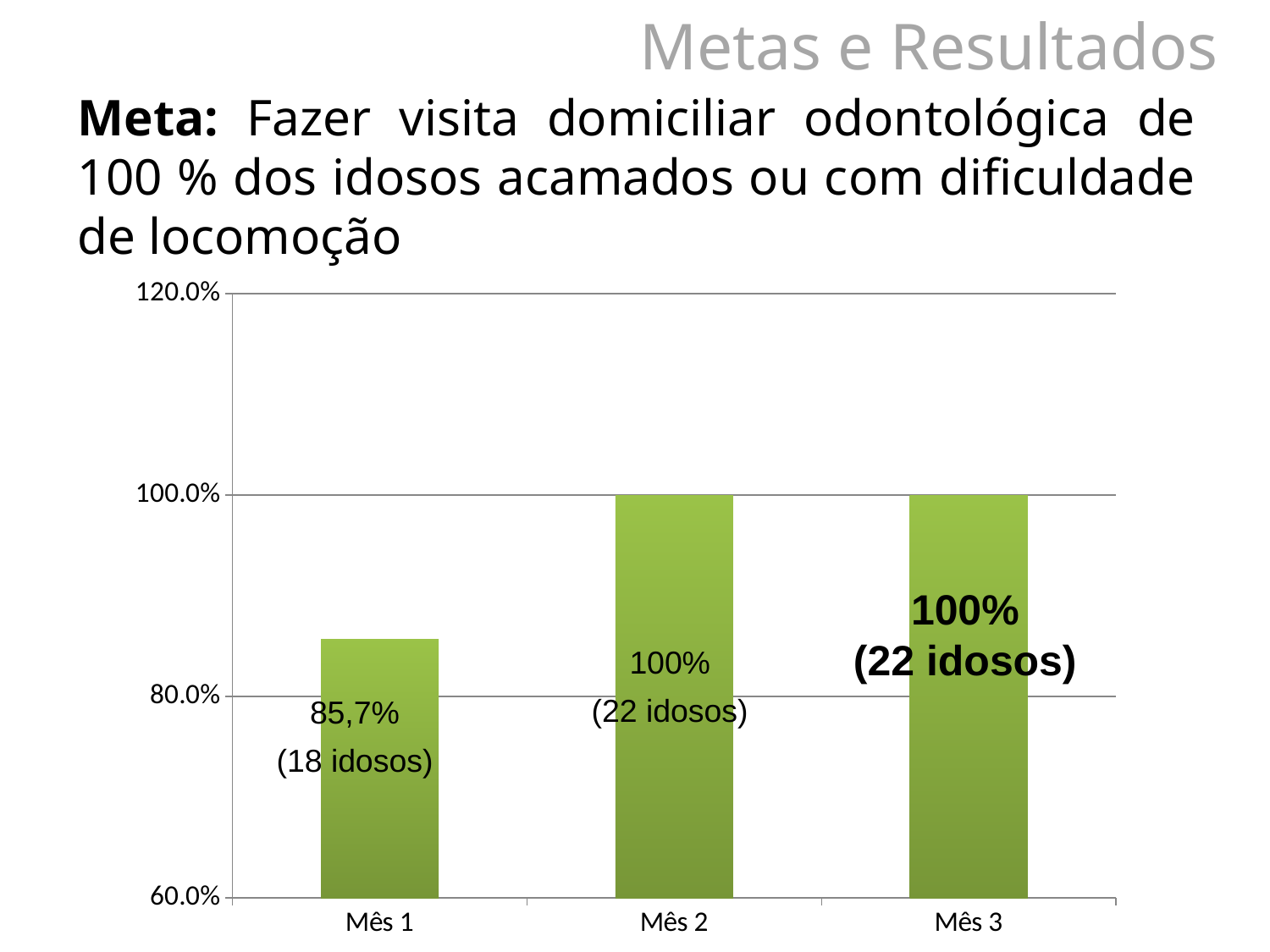
Is the value for Mês 1 greater or less than 80.0%? greater Which is larger, the value for Mês 1 or the value for Mês 3? Mês 3 Which month has the lowest value? Mês 1 What is the highest value shown on the y axis? 120.0% What is the value shown for Mês 1? 85,7% What kind of chart is shown on the slide? bar chart What is the difference between the value for Mês 2 and the value for Mês 1? 14,3% What is the value shown for Mês 2? 100% How many idosos does the label for Mês 1 indicate? 18 idosos How many months are shown on the x axis? 3 Do the values rise or fall from Mês 1 to Mês 2? rise How many idosos does the label for Mês 3 indicate? 22 idosos